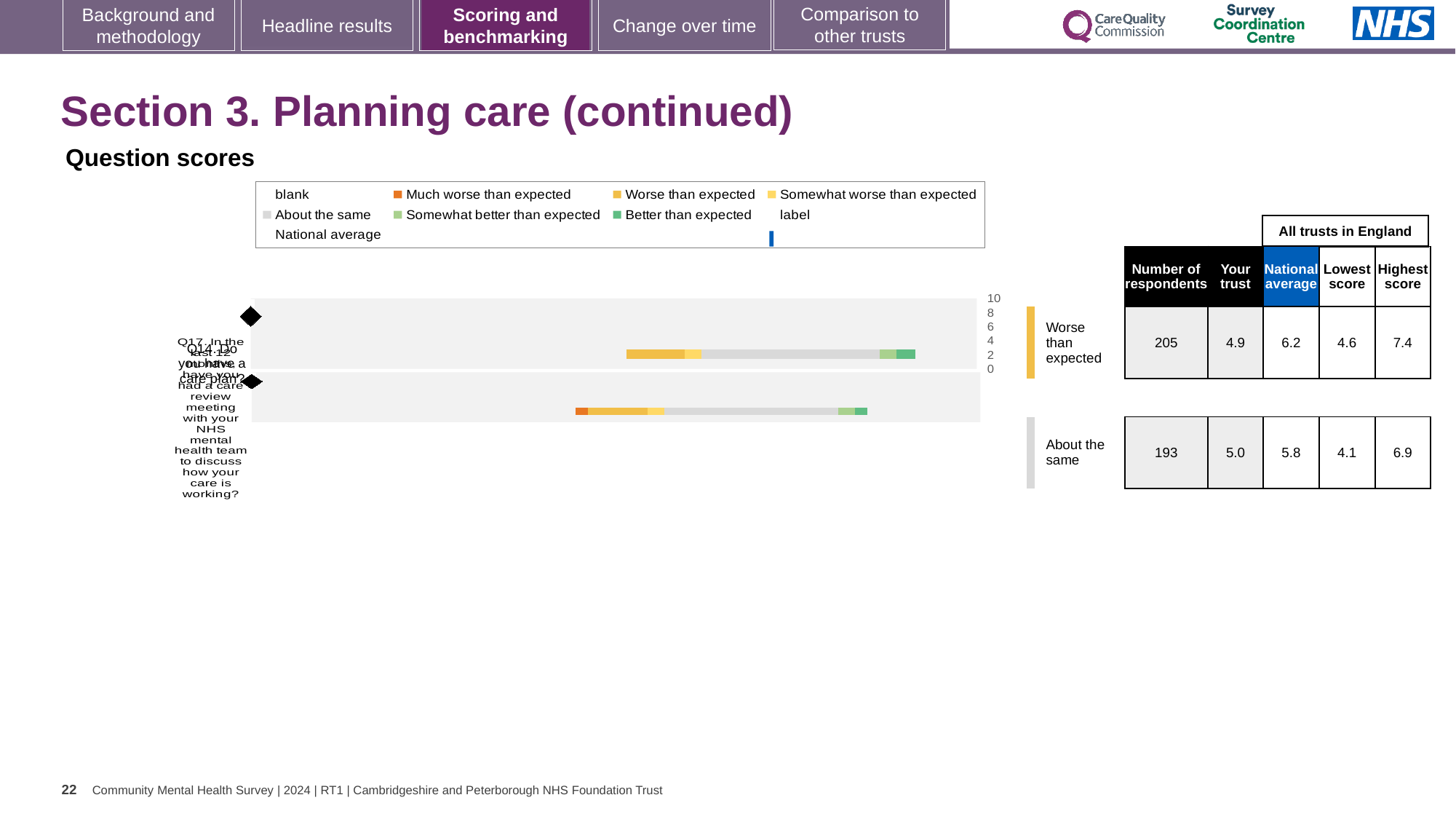
In the table, what is the national average for the row rated 'Worse than expected'? 6.2 In the table, what is the lowest score among all trusts in England for the row rated 'About the same'? 4.1 How many question rows are plotted in the chart? 2 In the table, which row has the higher 'Your trust' score: 'Worse than expected' or 'About the same'? About the same In the table, what is the number of respondents for the row rated 'Worse than expected'? 205 In the table, what is the highest score among all trusts in England for the row rated 'About the same'? 6.9 In the table, which row has more respondents: 'Worse than expected' or 'About the same'? Worse than expected In the table, what is the 'Your trust' score for the row rated 'Worse than expected'? 4.9 In the table, what is the difference between the national average and the 'Your trust' score for the row rated 'Worse than expected'? 1.3 What kind of chart is shown under 'Question scores'? bar chart In the table, what is the number of respondents for the row rated 'About the same'? 193 What is the highest value shown on the chart's numeric axis? 10